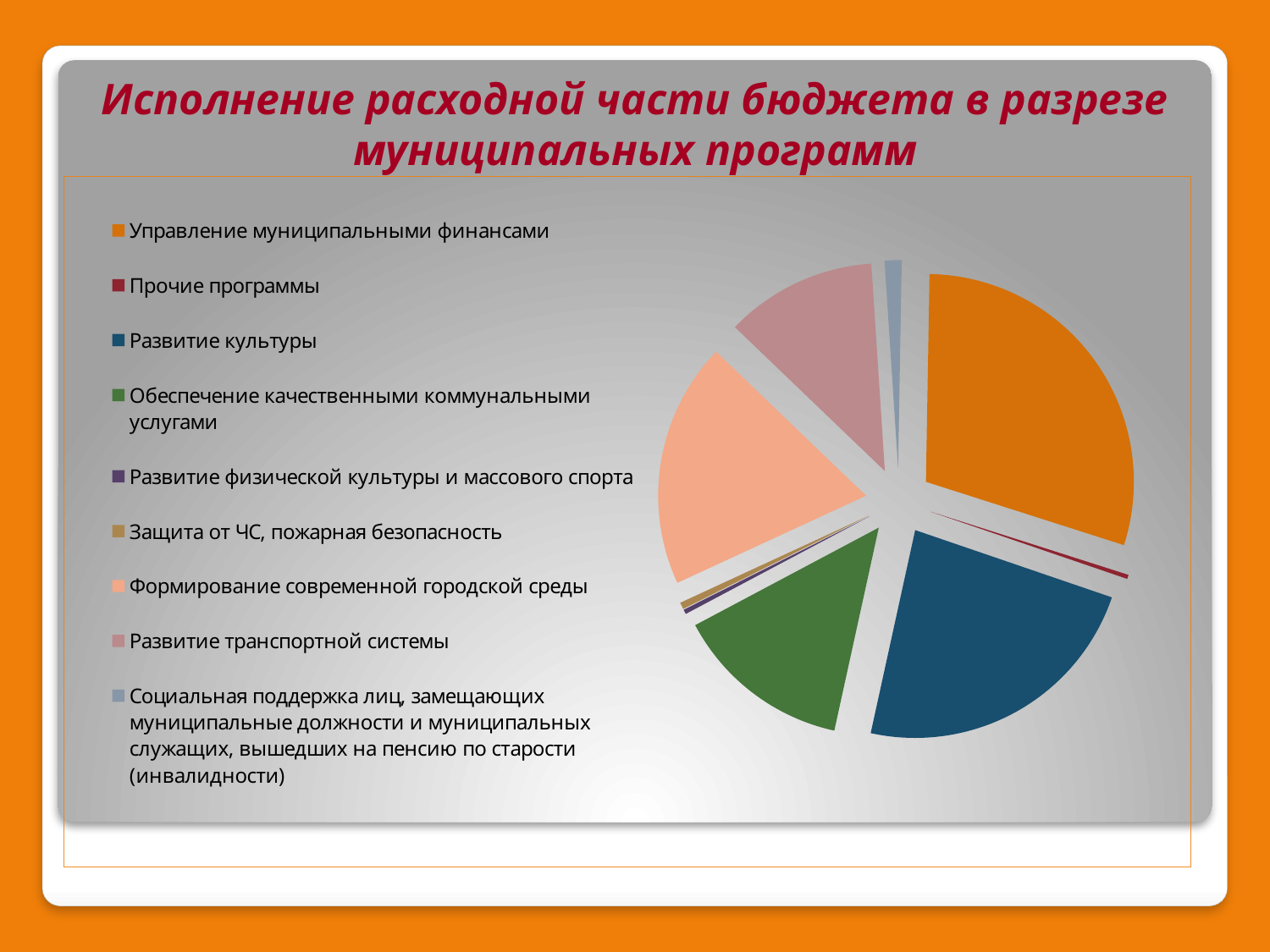
Which slice is larger: "Управление муниципальными финансами" or "Обеспечение качественными коммунальными услугами"? Управление муниципальными финансами Which slice is larger: "Обеспечение качественными коммунальными услугами" or "Прочие программы"? Обеспечение качественными коммунальными услугами What is the title of the slide containing the pie chart? Исполнение расходной части бюджета в разрезе муниципальных программ What kind of chart is shown on the slide? Pie chart Which colour represents "Управление муниципальными финансами" in the pie chart? Orange Which slice is larger: "Развитие культуры" or "Развитие транспортной системы"? Развитие культуры How many categories does the legend of the pie chart list? 9